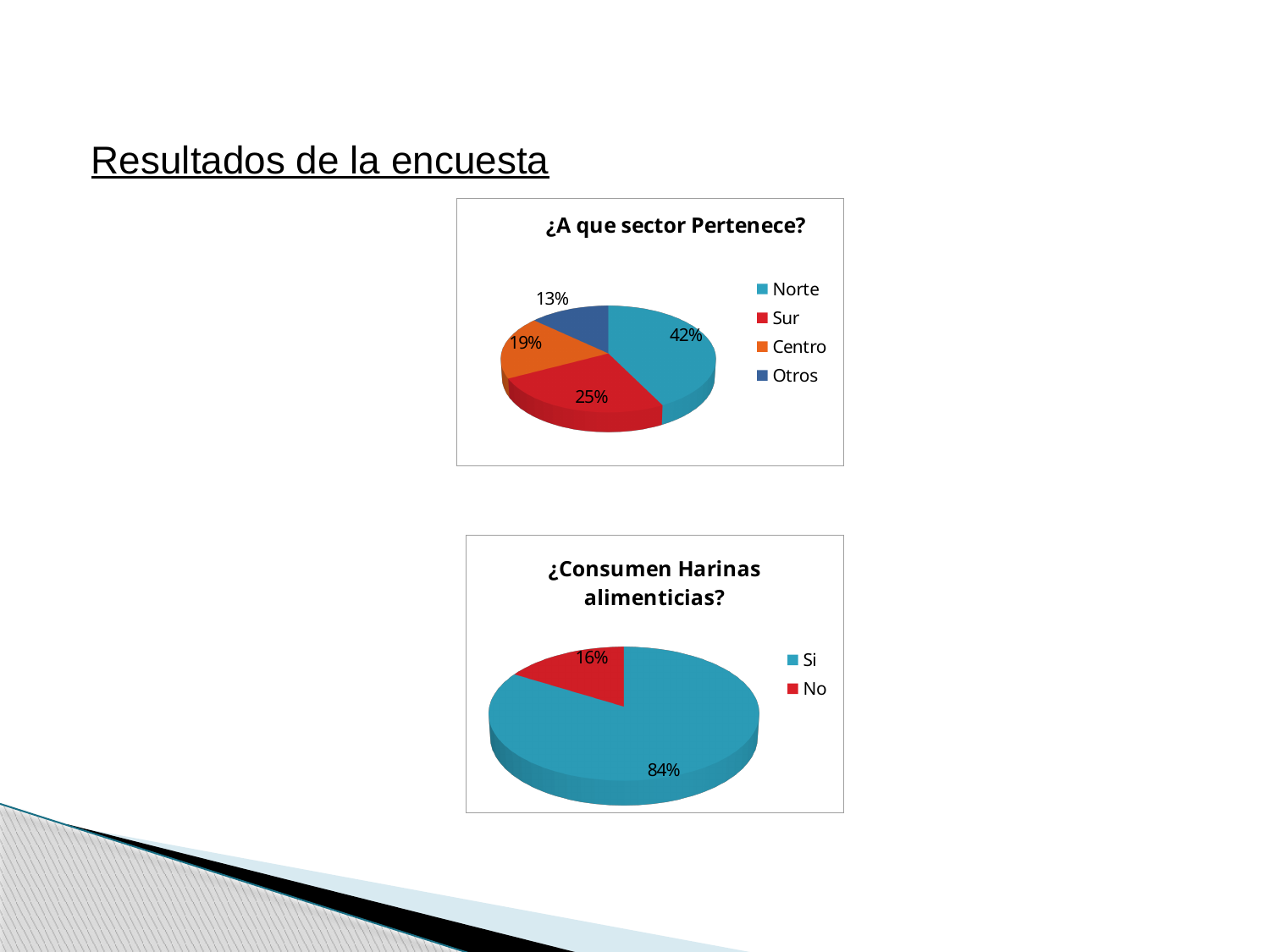
In the chart titled "¿A que sector Pertenece?", what is the difference between the Norte and Sur shares? 17% In the chart titled "¿Consumen Harinas alimenticias?", what colour is the No slice? Red In the chart titled "¿Consumen Harinas alimenticias?", what share does Si have? 84% In the chart titled "¿A que sector Pertenece?", what share does Centro have? 19% In the chart titled "¿A que sector Pertenece?", what share does Norte have? 42% What kind of chart is the chart titled "¿A que sector Pertenece?"? Pie chart In the chart titled "¿A que sector Pertenece?", how many categories does the legend list? 4 In the chart titled "¿A que sector Pertenece?", which sector has the smallest share? Otros In the chart titled "¿Consumen Harinas alimenticias?", which is larger, Si or No? Si In the chart titled "¿A que sector Pertenece?", which sector has the largest share? Norte